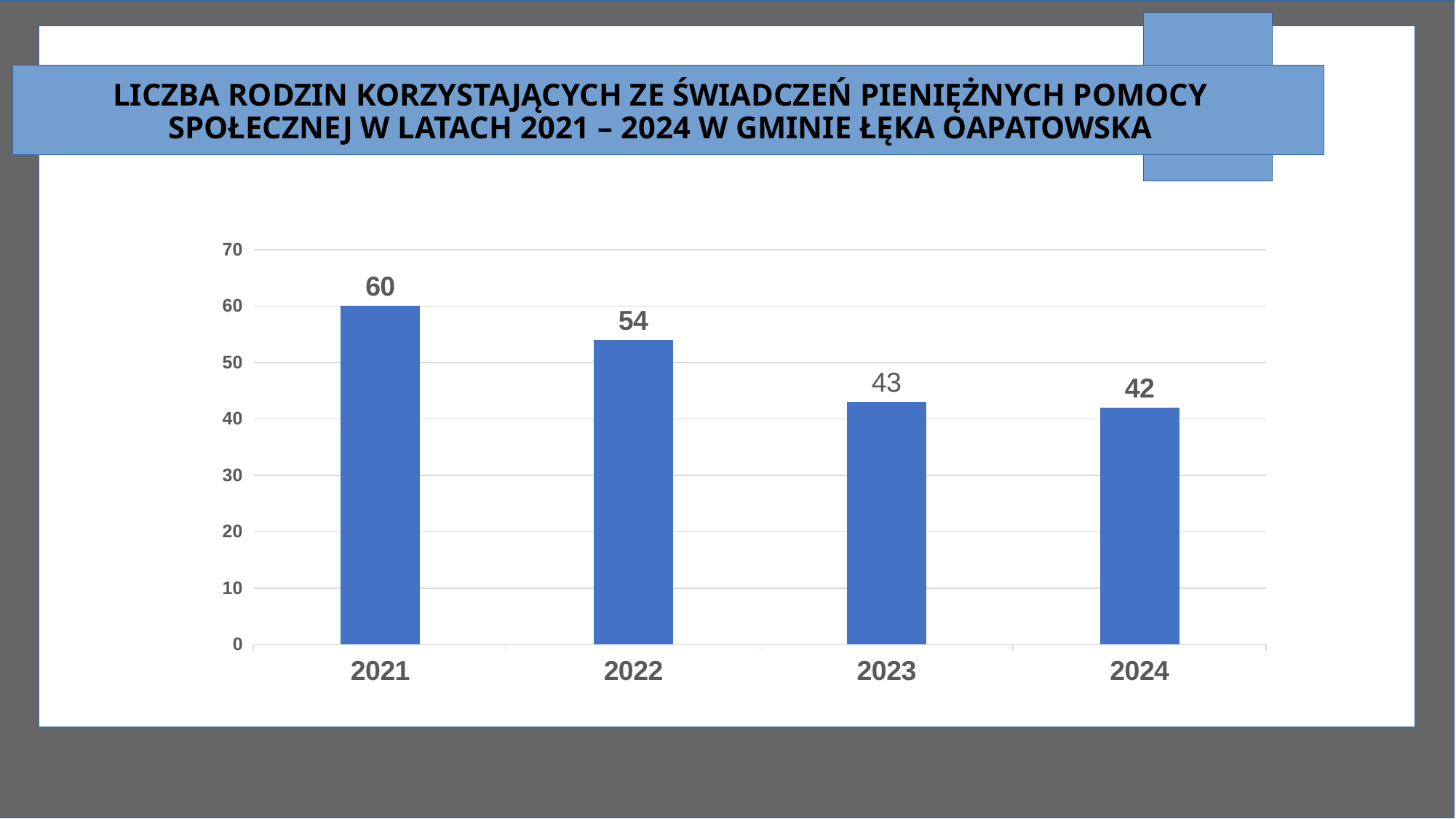
How many years are shown on the x axis? 4 What is the value for 2022? 54 What is the difference between the values for 2021 and 2024? 18 What is the difference between the values for 2022 and 2023? 11 What is the value for 2023? 43 Which year has the highest value? 2021 Which is larger, the value for 2022 or the value for 2023? 2022 What is the value for 2021? 60 Do the values rise or fall from 2021 to 2024? fall What kind of chart is shown on the slide? bar chart What is the value for 2024? 42 Which year has the lowest value? 2024